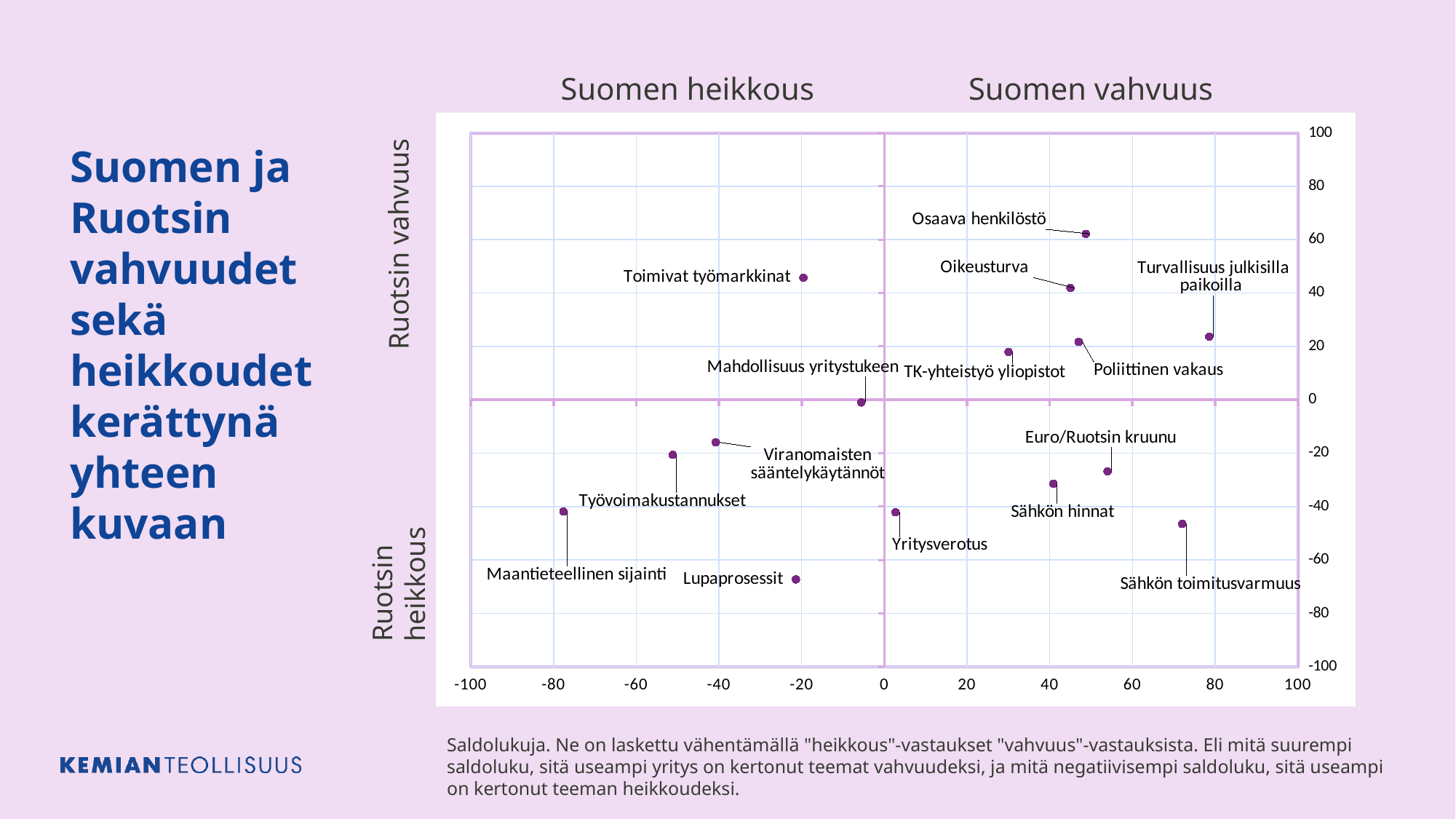
Is the vertical value for Turvallisuus julkisilla paikoilla greater or less than 40? less Is the horizontal value for Maantieteellinen sijainti greater or less than -60? less Which point lies furthest to the left on the horizontal axis? Maantieteellinen sijainti What kind of chart is shown on the slide? scatter chart Which point has the lowest vertical value on the chart? Lupaprosessit Is the vertical value for Lupaprosessit greater or less than -60? less Which label is shown above the right half of the chart? Suomen vahvuus How many labelled data points are plotted on the chart? 15 Which point lies furthest to the right on the horizontal axis? Turvallisuus julkisilla paikoilla Which point has the highest vertical (Ruotsin vahvuus) value? Osaava henkilöstö Which has the higher vertical value, Osaava henkilöstö or Oikeusturva? Osaava henkilöstö